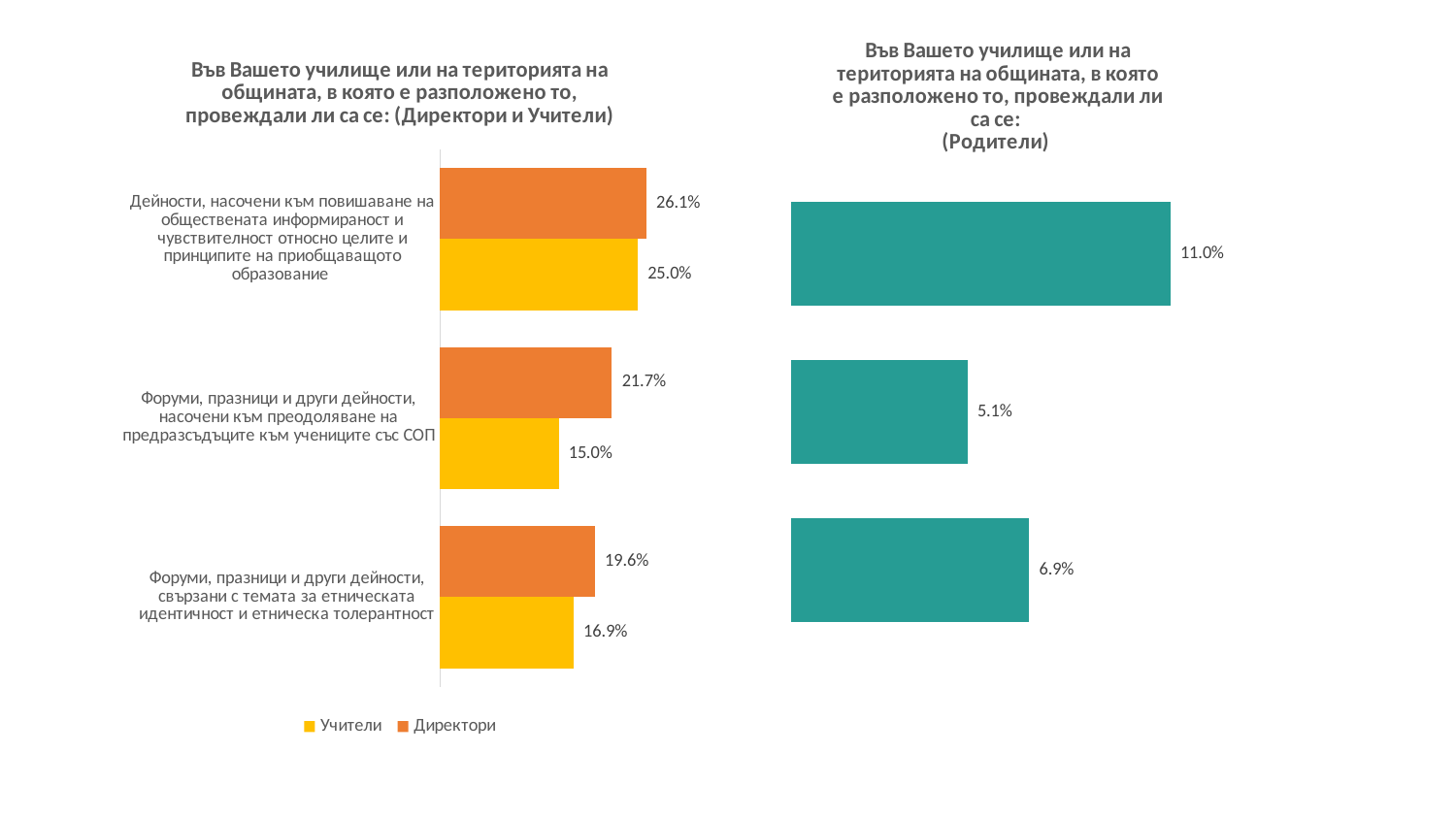
In the left chart (Директори и Учители), which is larger for 'Форуми, празници и други дейности, свързани с темата за етническата идентичност и етническа толерантност': Директори or Учители? Директори In the left chart (Директори и Учители), what is the value for Учители for 'Форуми, празници и други дейности, насочени към преодоляване на предразсъдъците към учениците със СОП'? 15.0% In the left chart (Директори и Учители), what is the value for Учители for 'Форуми, празници и други дейности, свързани с темата за етническата идентичност и етническа толерантност'? 16.9% In the right chart (Родители), what is the difference between the top bar and the middle bar? 5.9% In the left chart (Директори и Учители), which category has the highest value for Директори? Дейности, насочени към повишаване на обществената информираност и чувствителност относно целите и принципите на приобщаващото образование In the left chart (Директори и Учители), which category has the lowest value for Учители? Форуми, празници и други дейности, насочени към преодоляване на предразсъдъците към учениците със СОП How many categories are shown in the left chart (Директори и Учители)? 3 How many series does the legend of the left chart (Директори и Учители) list? 2 In the right chart (Родители), what is the value of the top bar? 11.0% What kind of chart is the right chart (Родители)? Bar chart In the left chart (Директори и Учители), what is the difference between Директори and Учители for 'Форуми, празници и други дейности, насочени към преодоляване на предразсъдъците към учениците със СОП'? 6.7% In the left chart (Директори и Учители), what is the value for Директори for 'Дейности, насочени към повишаване на обществената информираност и чувствителност относно целите и принципите на приобщаващото образование'? 26.1%